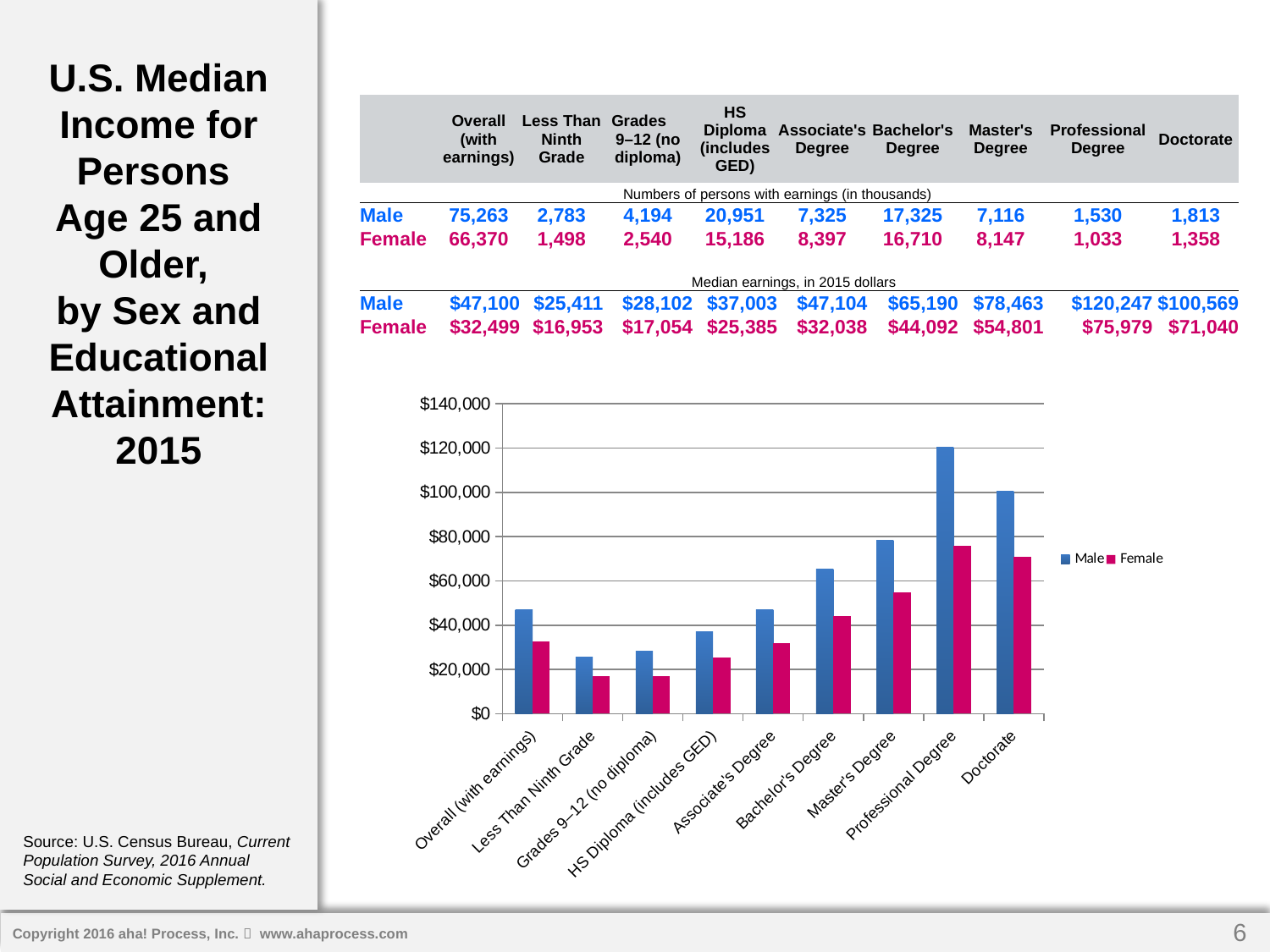
Which category has the lowest Female median earnings? Less Than Ninth Grade What is the difference between Male and Female median earnings for Doctorate? $29,529 What is the median earnings value for Male with a Professional Degree? $120,247 How many series does the chart's legend list? 2 What kind of chart is shown on the slide? bar chart Is the Female median earnings value for Professional Degree greater or less than $80,000? less Do Male median earnings generally rise or fall from Less Than Ninth Grade through Professional Degree along the x axis? rise What is the median earnings value for Female with a Bachelor's Degree? $44,092 Which category has the highest Male median earnings? Professional Degree What colour are the Female bars in the chart? pink/magenta Which is larger, Male median earnings for Master's Degree or Male median earnings for Doctorate? Doctorate How many educational attainment categories are plotted along the x axis of the chart? 9